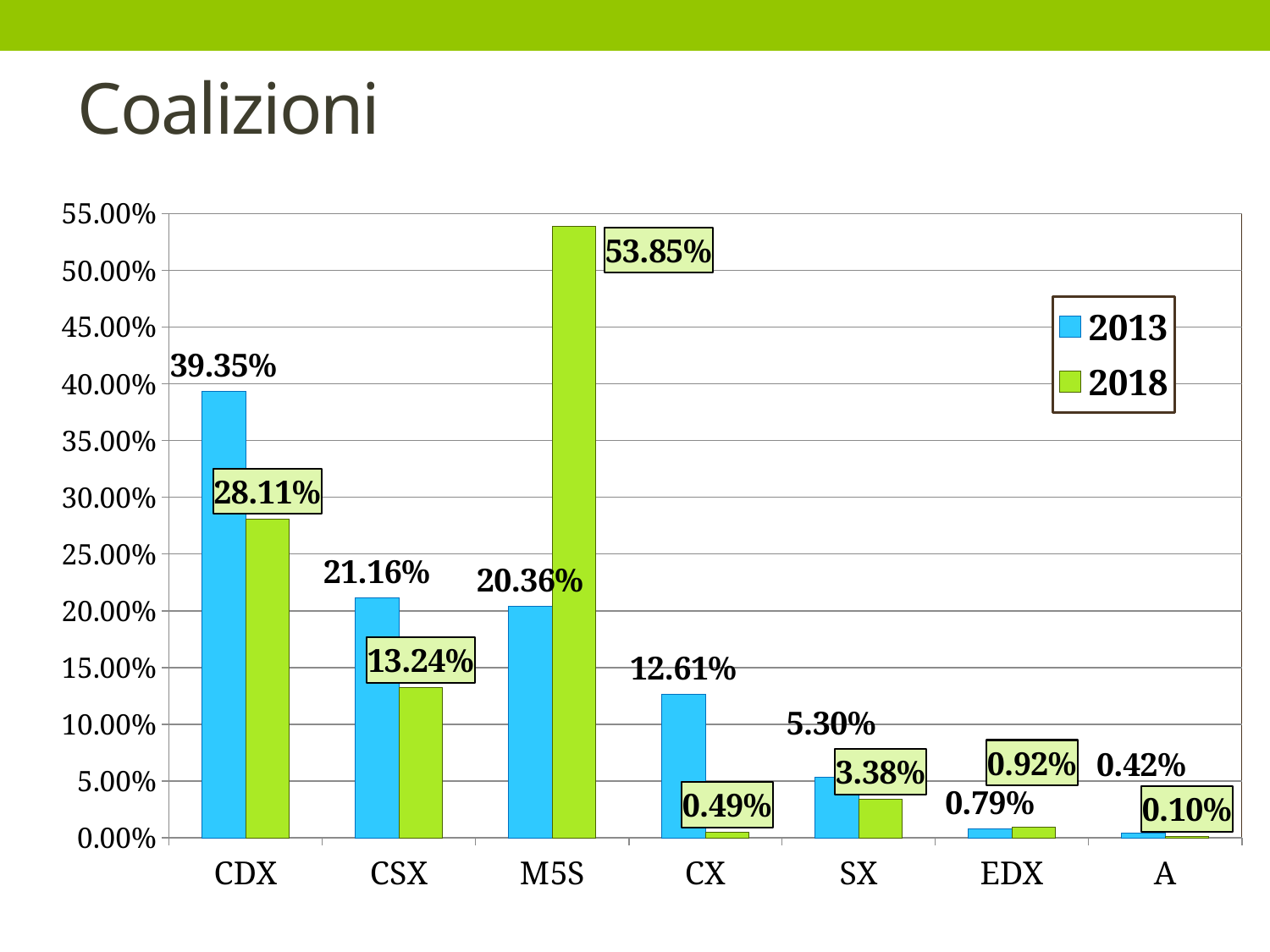
What type of chart is shown on the slide? Bar chart Which category has the highest 2018 value? M5S What is the difference between the 2013 and 2018 values for CDX? 11.24% What is the 2013 value for SX? 5.30% How many series does the legend list? 2 Which category has the lowest 2013 value? A What is the 2018 value for CX? 0.49% How many categories are shown on the x axis? 7 What is the 2018 value for M5S? 53.85% What is the 2013 value for CDX? 39.35% What is the difference between the 2018 and 2013 values for M5S? 33.49% Which is larger for EDX, the 2013 value or the 2018 value? 2018